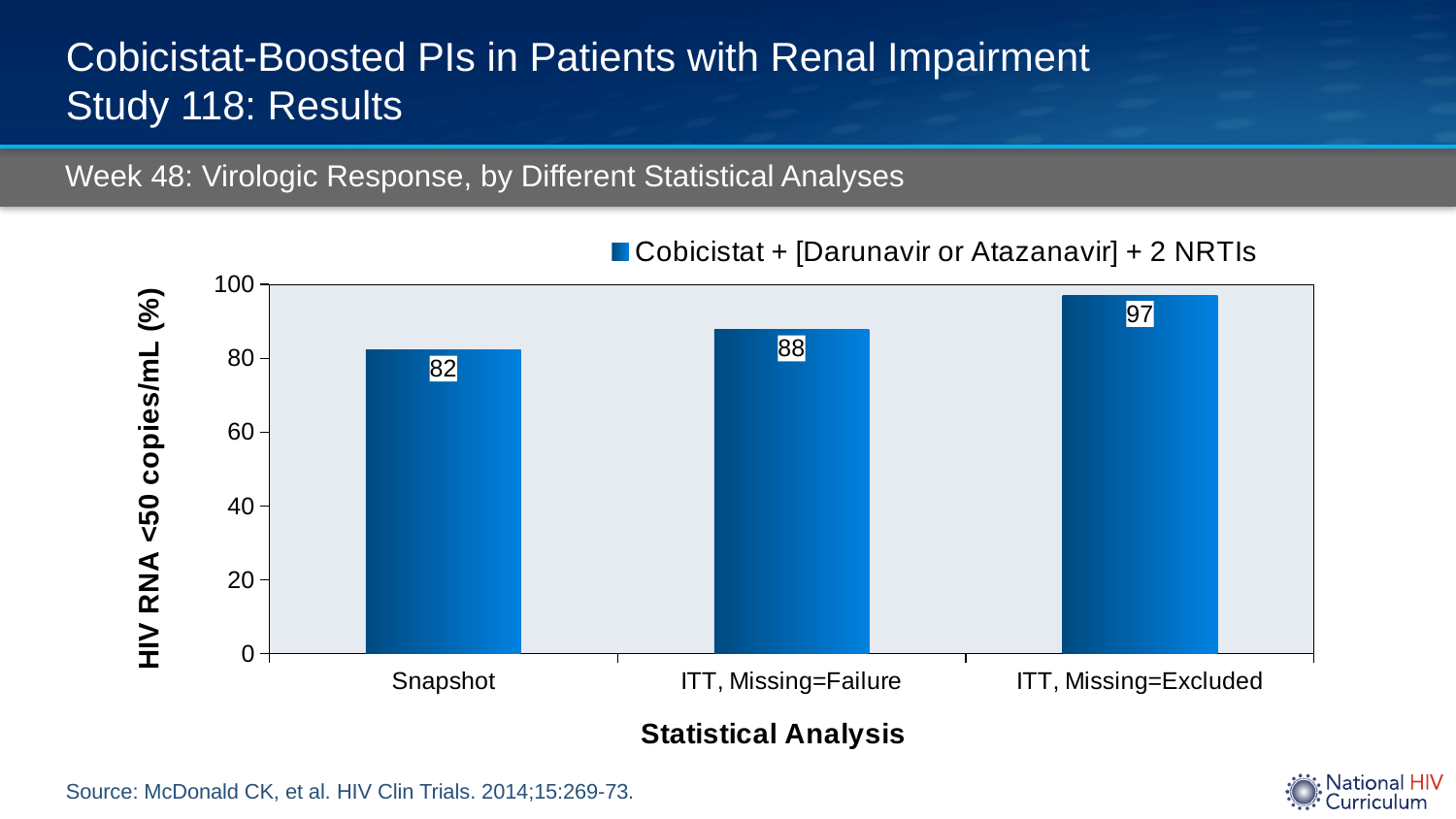
What is the value for ITT, Missing=Excluded? 97 What kind of chart is shown on the slide? Bar chart What is the difference between the values for ITT, Missing=Failure and Snapshot? 6 What series does the legend list? Cobicistat + [Darunavir or Atazanavir] + 2 NRTIs What is the difference between the values for ITT, Missing=Excluded and Snapshot? 15 How many statistical analysis categories are shown on the x axis? 3 Which is larger, the value for Snapshot or the value for ITT, Missing=Failure? ITT, Missing=Failure Is the value for Snapshot greater or less than 80? greater Which statistical analysis has the lowest value? Snapshot What is the value for Snapshot? 82 What is the value for ITT, Missing=Failure? 88 Which statistical analysis has the highest value? ITT, Missing=Excluded